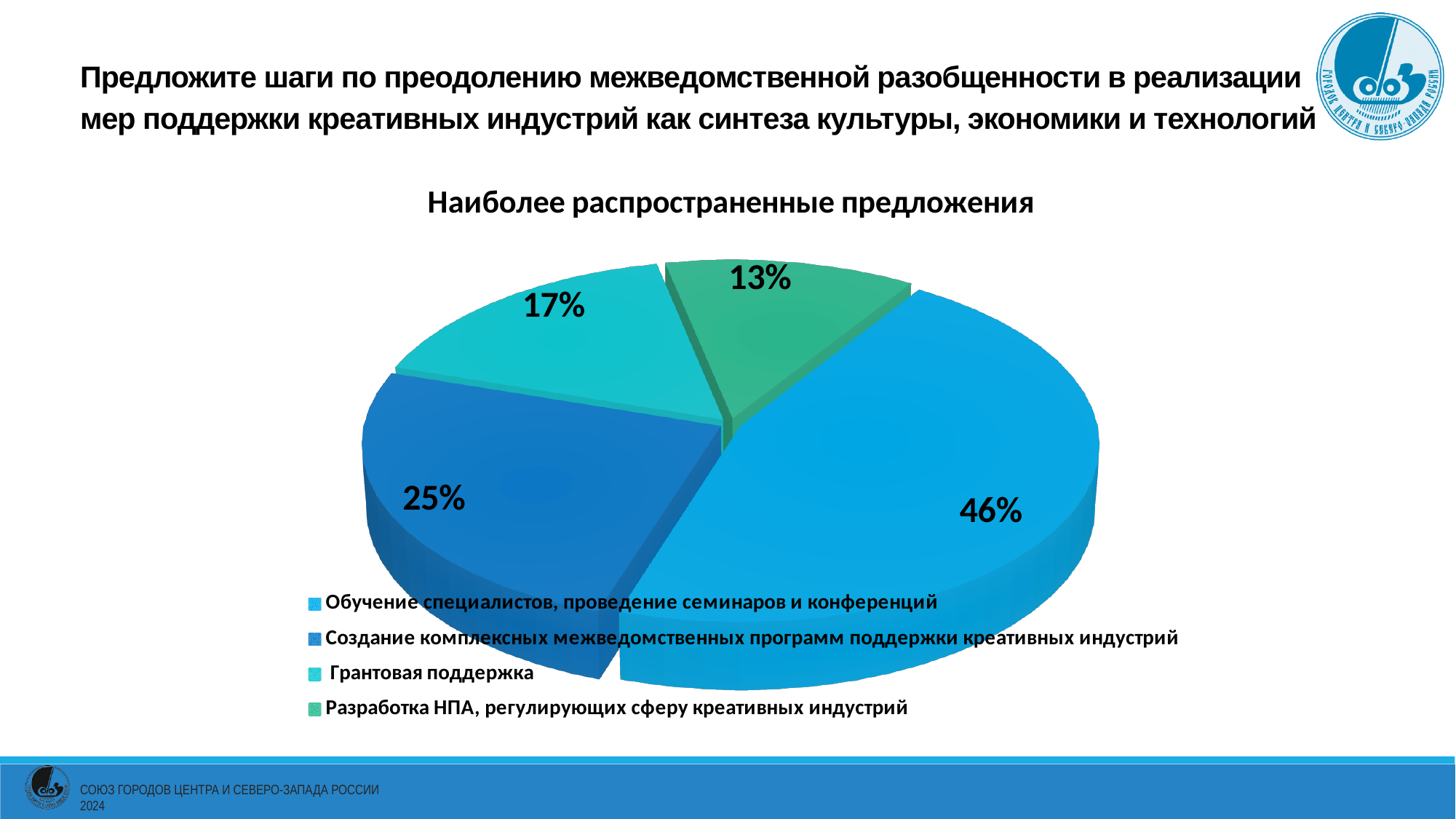
Which category is shown in green in the pie chart? Разработка НПА, регулирующих сферу креативных индустрий What kind of chart is shown on the slide? pie chart Which is larger: the share for 'Грантовая поддержка' or the share for 'Разработка НПА, регулирующих сферу креативных индустрий'? Грантовая поддержка What is the difference in percentage points between 'Обучение специалистов, проведение семинаров и конференций' and 'Создание комплексных межведомственных программ поддержки креативных индустрий'? 21% What share of the pie is 'Грантовая поддержка'? 17% Which category has the largest share of the pie? Обучение специалистов, проведение семинаров и конференций What share of the pie is 'Разработка НПА, регулирующих сферу креативных индустрий'? 13% How many slices does the pie chart have? 4 What share of the pie is 'Обучение специалистов, проведение семинаров и конференций'? 46% What is the title of the chart? Наиболее распространенные предложения Which category has the smallest share of the pie? Разработка НПА, регулирующих сферу креативных индустрий